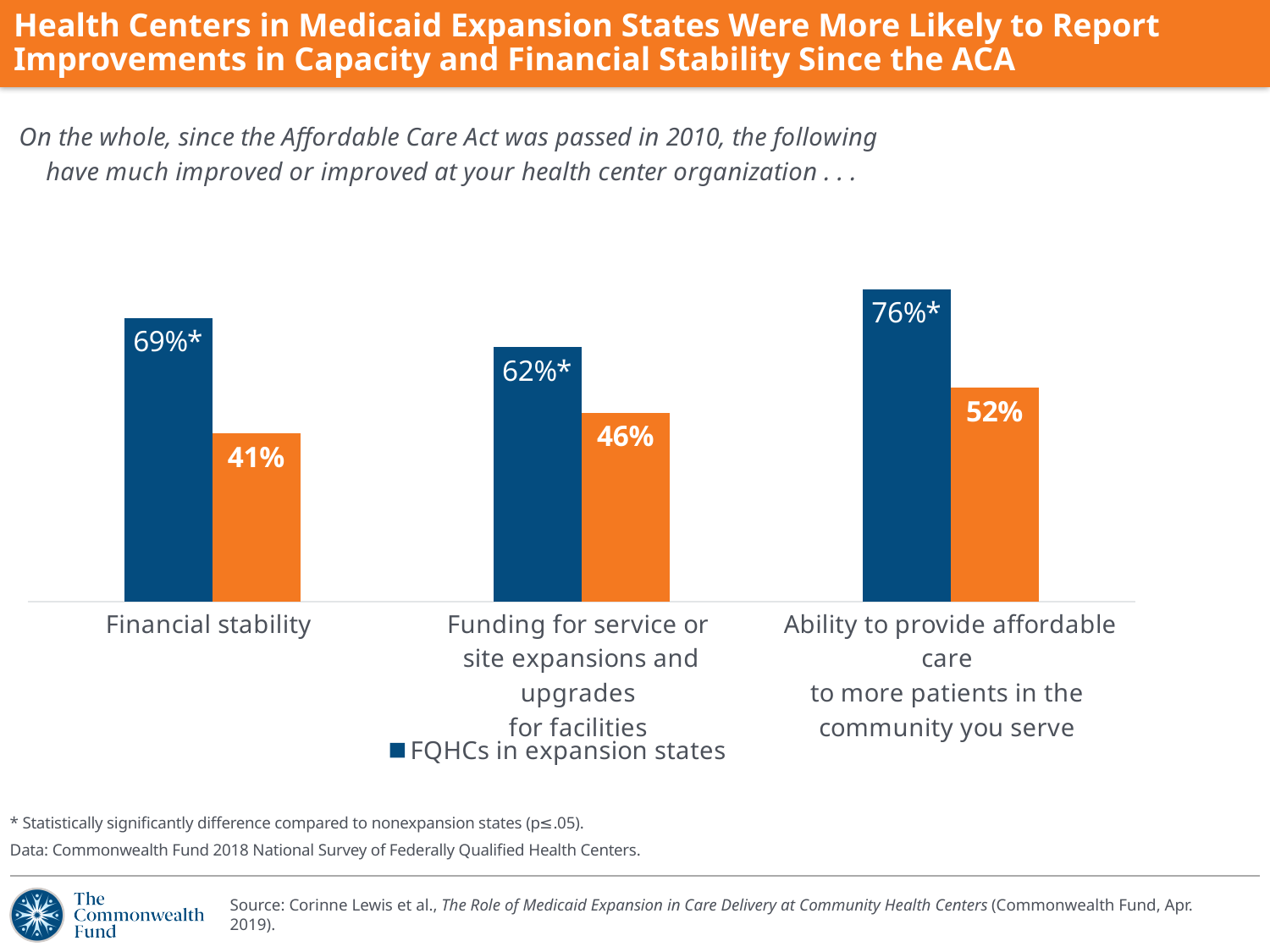
What percentage of FQHCs in expansion states reported improvement in funding for service or site expansions and upgrades for facilities? 62% What percentage of FQHCs in expansion states reported improvement in financial stability? 69% Which is larger: the orange bar for Funding for service or site expansions and upgrades for facilities, or the orange bar for Financial stability? Funding for service or site expansions and upgrades for facilities What is the difference between the blue and orange bars for Financial stability? 28 percentage points What value is shown on the orange bar for Ability to provide affordable care to more patients in the community you serve? 52% What is the difference between the blue and orange bars for Ability to provide affordable care to more patients in the community you serve? 24 percentage points How many categories are shown on the x axis of the chart? 3 For which category is the value for FQHCs in expansion states highest? Ability to provide affordable care to more patients in the community you serve What kind of chart is shown on the slide? Bar chart What series name does the legend list? FQHCs in expansion states What value is shown on the orange bar for Financial stability? 41% For which category is the orange bar lowest? Financial stability